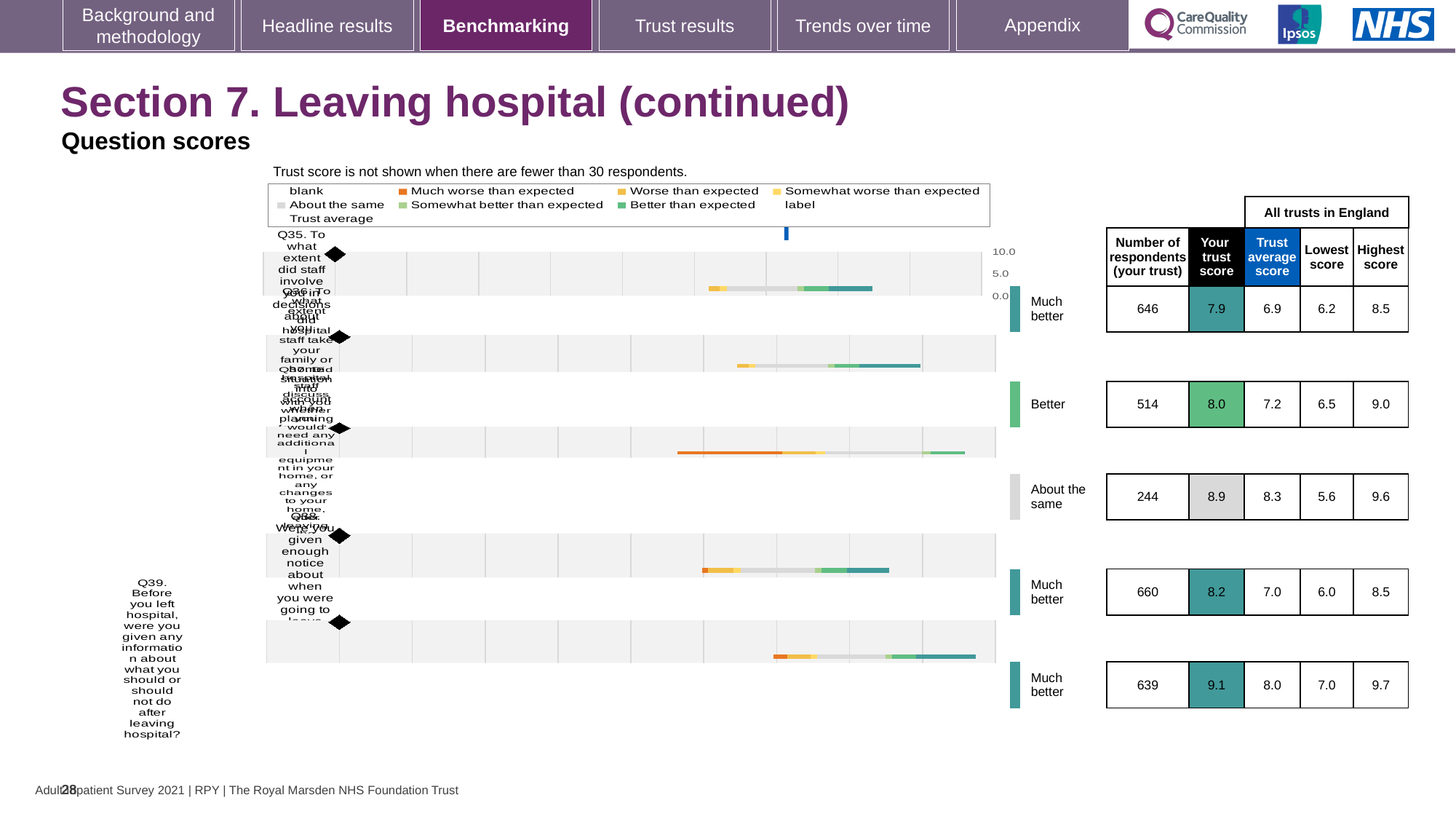
What is the difference between the trust score and the trust average score for Q39? 1.1 How many questions (rows) are shown in the benchmarking table on this slide? 5 Which row of the table has the highest 'Your trust score'? Q39 (9.1) What is the trust average score for Q39? 8.0 What is the number of respondents for Q39 (information about what you should or should not do after leaving hospital)? 639 For the question rated 'About the same', what is the number of respondents? 244 What is the trust score for Q39 (information about what you should or should not do after leaving hospital)? 9.1 What kind of chart is used to show the question scores on this slide? bar chart What is the highest score across all trusts in England for Q39? 9.7 What is the maximum value shown on the score axis of the chart? 10.0 What is the lowest 'Your trust score' shown in the table? 7.9 For the question rated 'Better', which is larger: the trust score or the trust average score? the trust score (8.0)